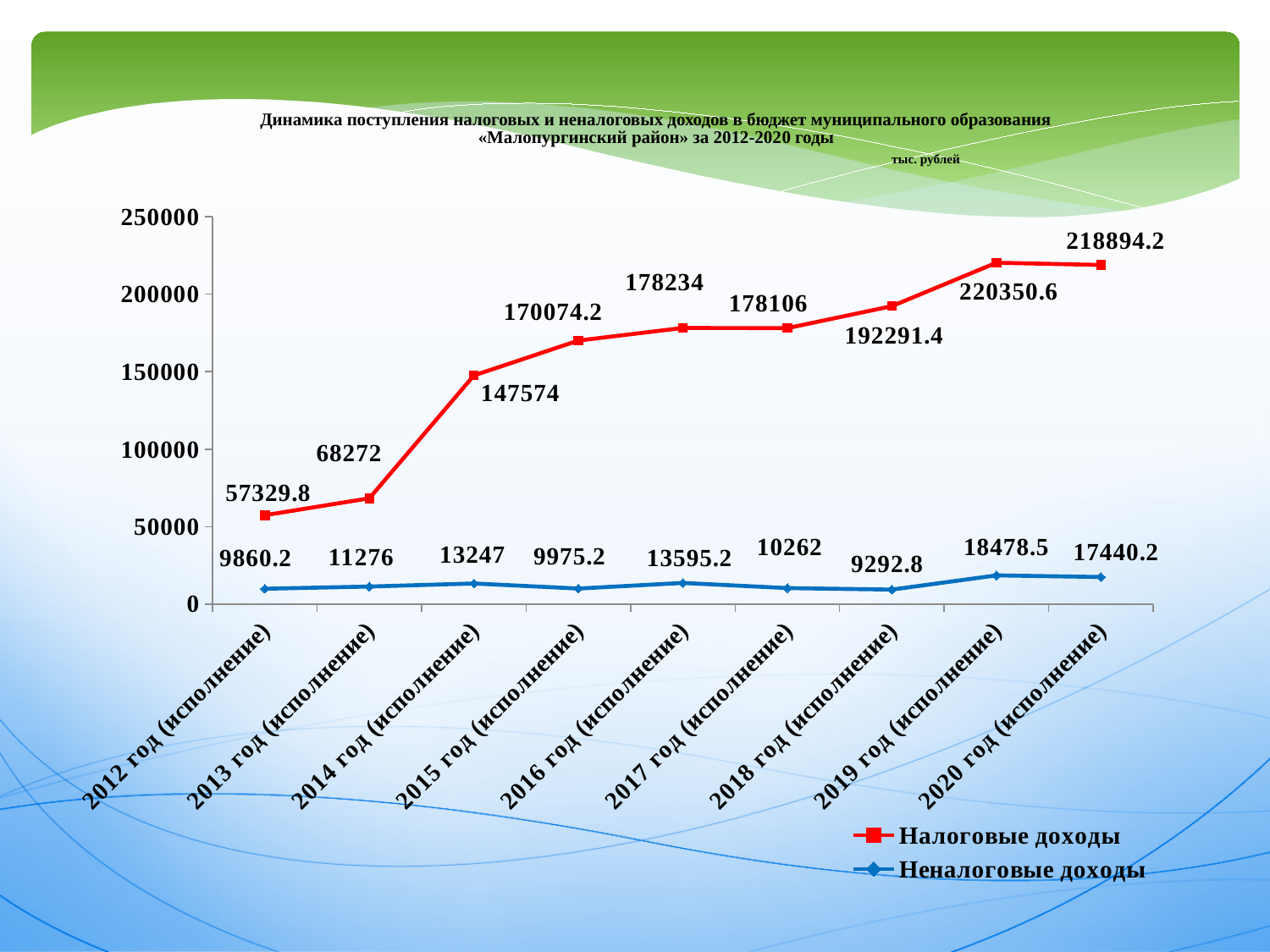
Is the value of Налоговые доходы for 2015 greater or less than 150000? greater What is the value of Неналоговые доходы for 2019 год (исполнение)? 18478.5 How many series does the legend list? 2 Which series is drawn in red with square markers? Налоговые доходы In which year is Налоговые доходы the highest? 2019 год (исполнение) What is the difference between Налоговые доходы in 2013 and 2012? 10942.2 Which is larger: Неналоговые доходы in 2016 or in 2017? 2016 How many years (categories) are plotted on the x axis? 9 In which year is Неналоговые доходы the lowest? 2018 год (исполнение) What type of chart is shown on the slide? Line chart What is the value of Налоговые доходы for 2014 год (исполнение)? 147574 What is the value of Налоговые доходы for 2020 год (исполнение)? 218894.2